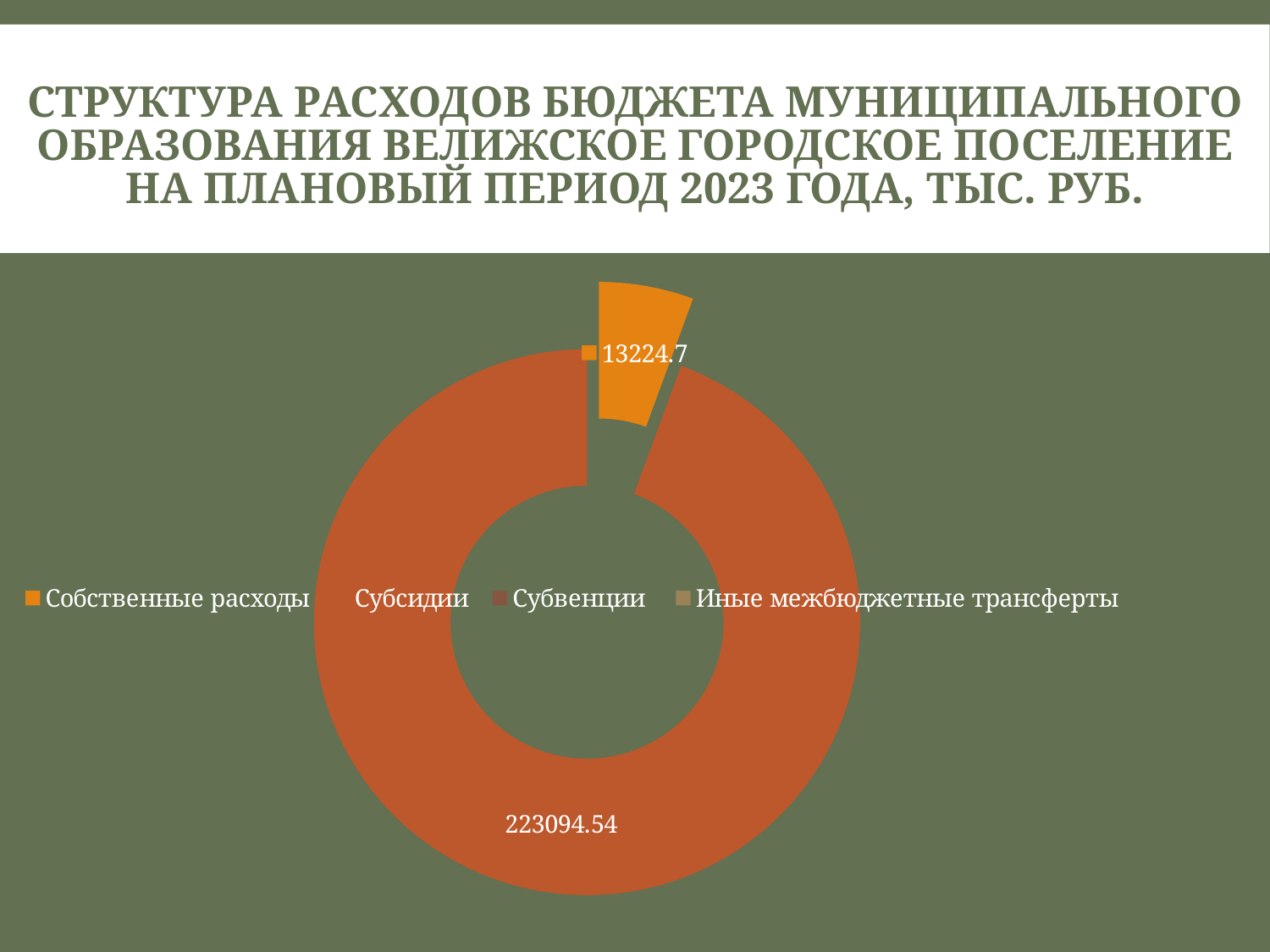
Which is larger: the slice labelled 13224.7 or the slice labelled 223094.54? 223094.54 How many slices in the chart carry a data label? 2 What kind of chart is shown on the slide? Doughnut (pie) chart Which labelled slice of the chart is the smallest? Собственные расходы (13224.7) How many entries does the legend list? 4 Which legend category is shown in orange? Собственные расходы What value is labelled on the largest slice of the doughnut chart? 223094.54 What is the difference between the two labelled values, 223094.54 and 13224.7? 209869.84 What is the last entry in the chart legend? Иные межбюджетные трансферты What value is labelled on the orange slice (Собственные расходы)? 13224.7